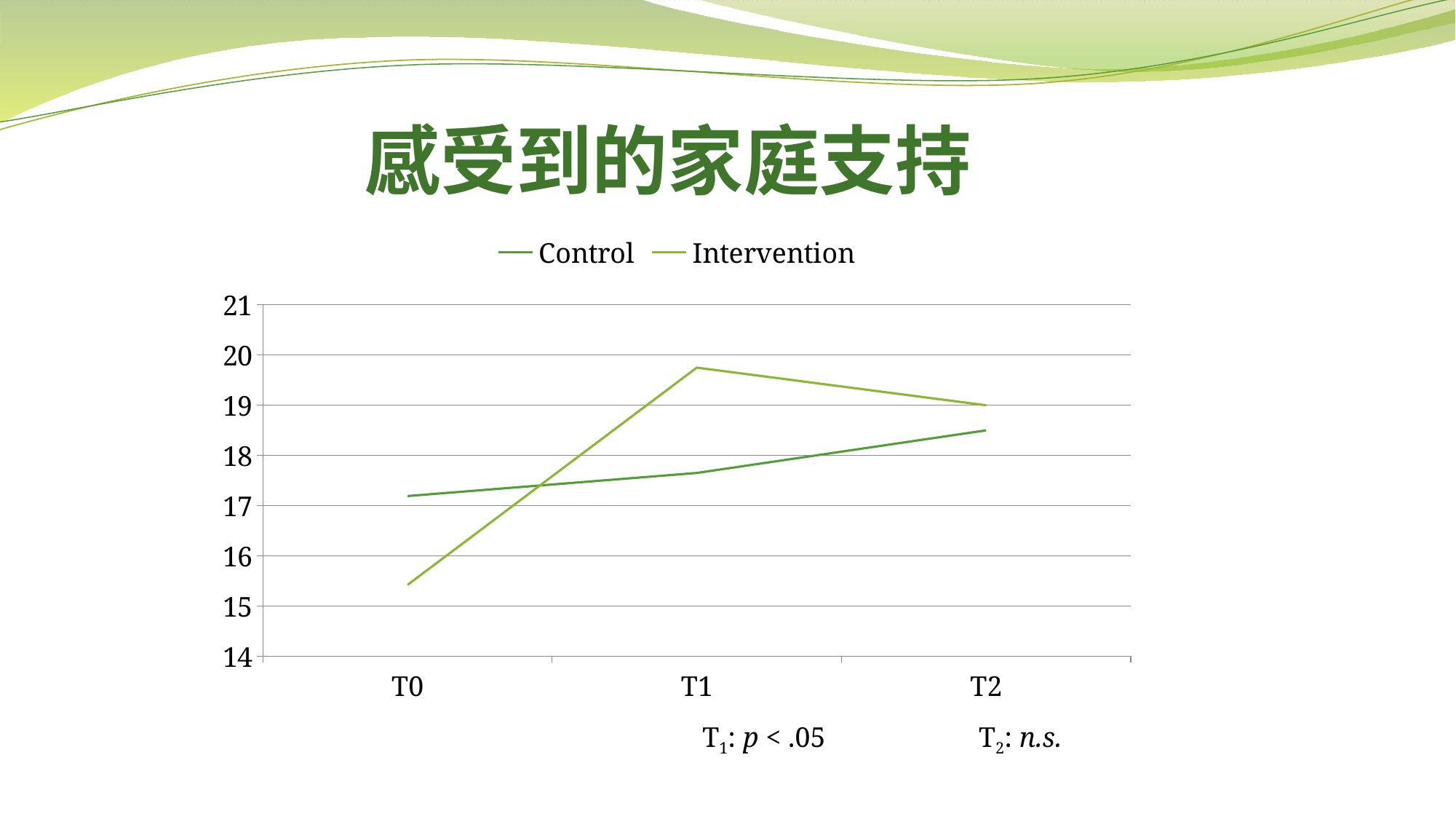
Is the value for Intervention at T0 greater or less than 16? less How many time points are shown on the x axis? 3 What are the two series named in the legend? Control and Intervention What kind of chart is shown on the slide? line chart At T0, which series has the higher value, Control or Intervention? Control Does the Control series rise or fall from T0 to T2? rise At which time point does the Intervention series reach its highest value? T1 How many series does the legend list? 2 Is the value for Intervention at T1 greater or less than 19? greater At T1, which series has the higher value, Control or Intervention? Intervention Is the value for Control at T0 greater or less than 17? greater